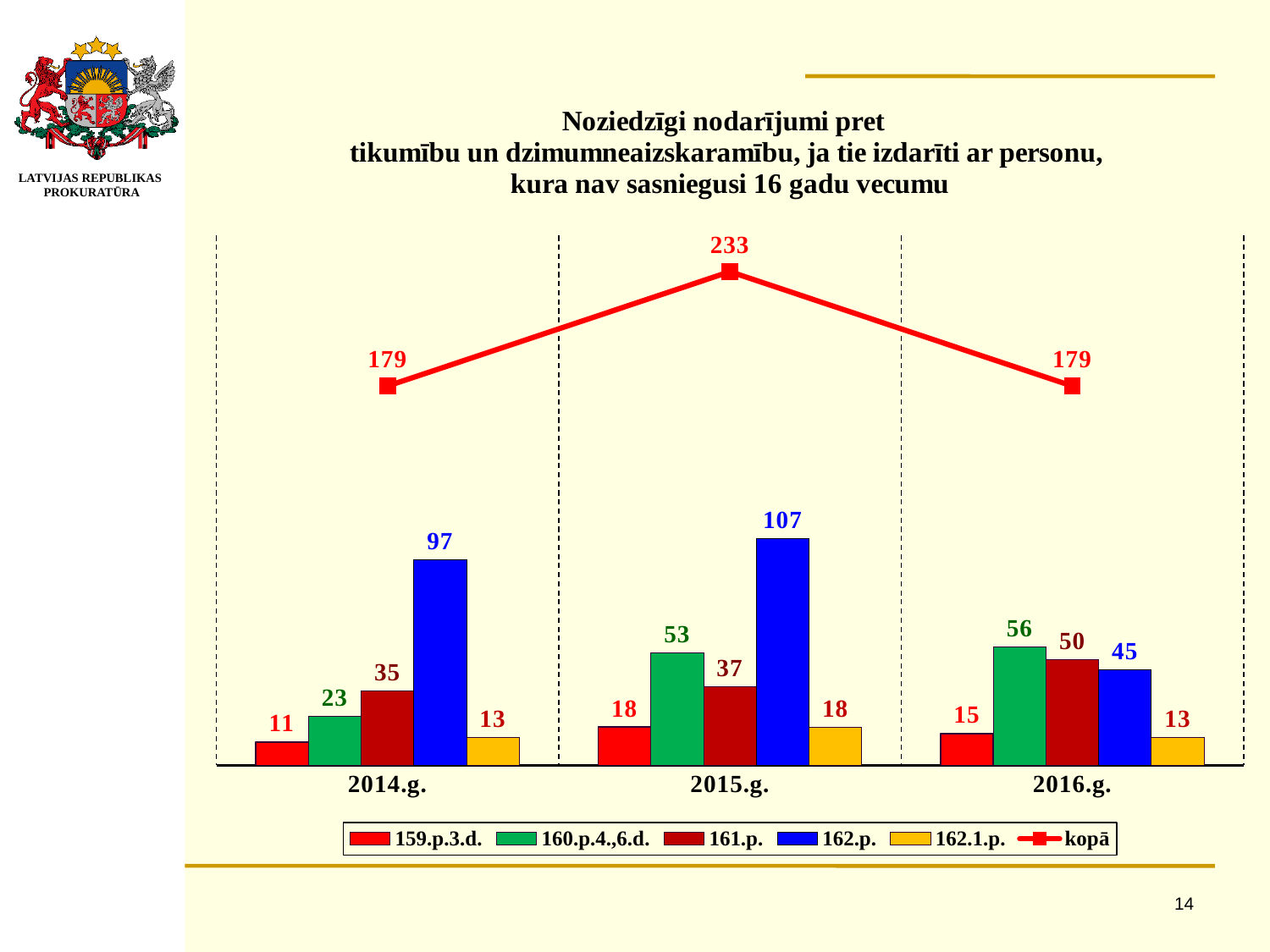
Does the value for 162.p. rise or fall from 2015.g. to 2016.g.? Fall What is the kopā value for 2016.g.? 179 What is the value for 160.p.4.,6.d. in 2016.g.? 56 Which is larger: the value for 162.p. in 2016.g. or the value for 161.p. in 2016.g.? 161.p. What is the difference between the kopā values for 2015.g. and 2014.g.? 54 What is the value for 161.p. in 2014.g.? 35 What is the value for 162.p. in 2015.g.? 107 How many years are shown on the x axis? 3 What kind of chart is shown on the slide? Combined bar and line chart In which year is the kopā value highest? 2015.g. How many series does the legend list? 6 Which series has the lowest value in 2014.g.? 159.p.3.d.